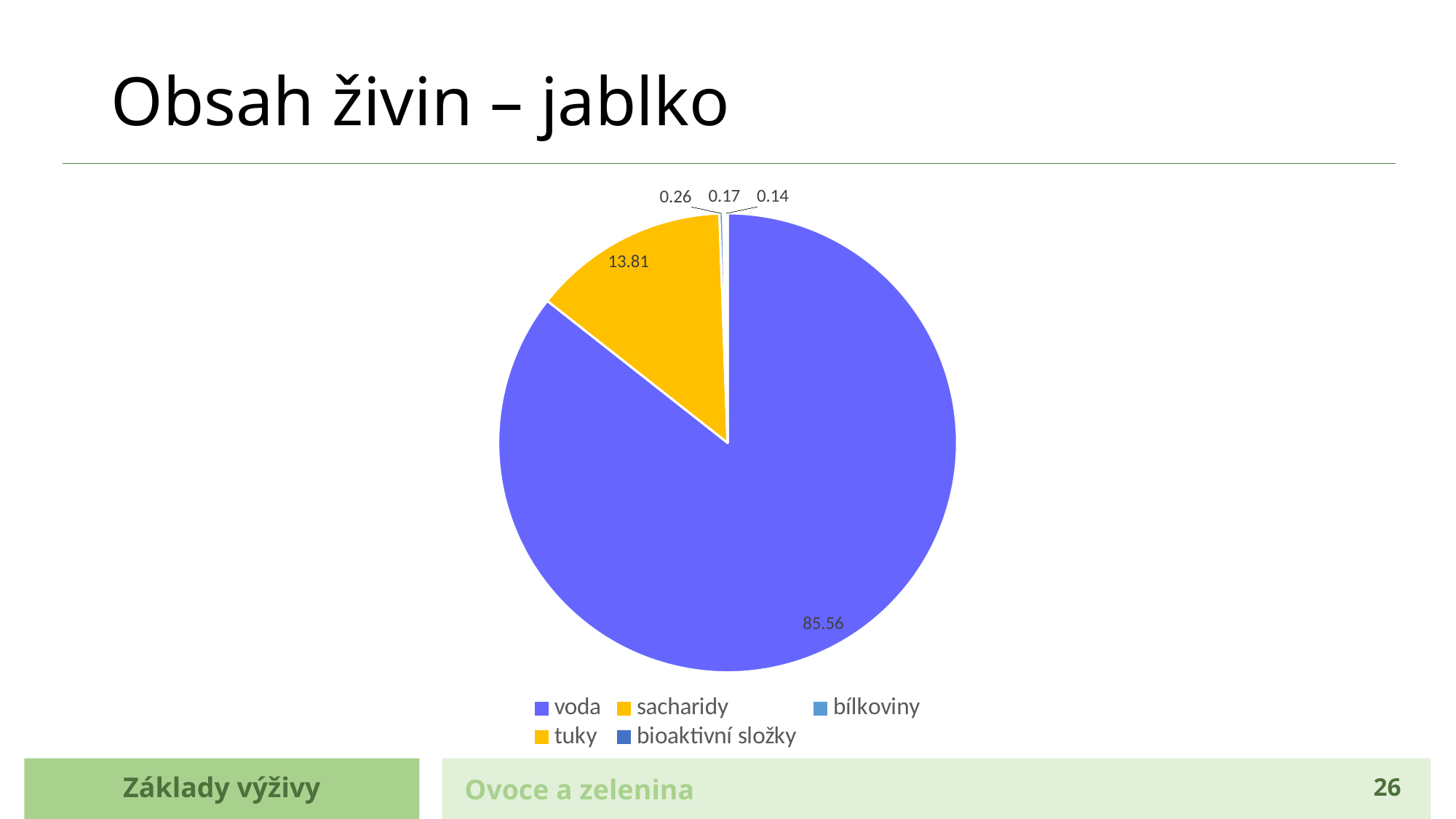
What colour is the slice for sacharidy? yellow What is the smallest value labelled on the pie chart? 0.14 How many data labels are printed on the pie chart? 5 Which category has the largest slice of the pie? voda What is the difference between the values for voda and sacharidy? 71.75 What is the value shown for sacharidy? 13.81 Which is larger, the value for voda or the value for sacharidy? voda What is the title of the slide containing the chart? Obsah živin – jablko What type of chart is shown on the slide? pie chart How many categories does the legend list? 5 What is the value shown for voda? 85.56